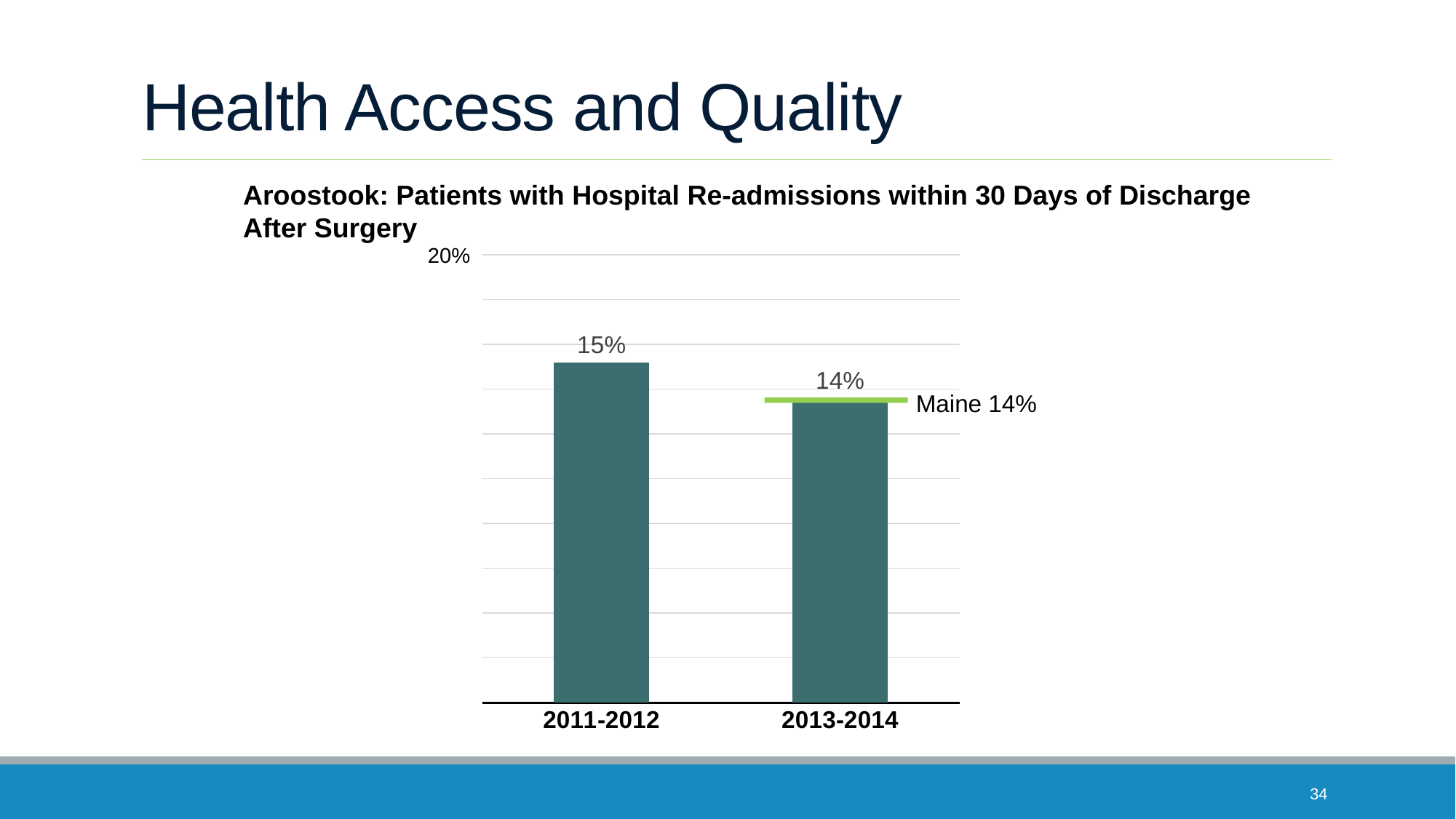
Which period has the highest value? 2011-2012 What is the difference between the 2011-2012 and 2013-2014 values? 1% What is the value for 2013-2014? 14% Which period has the lowest value? 2013-2014 What is the value for 2011-2012? 15% How many periods are shown on the x axis? 2 Is the value for 2011-2012 greater or less than 20%? less What is the title of the chart? Aroostook: Patients with Hospital Re-admissions within 30 Days of Discharge After Surgery What is the Maine reference value marked by the green line? 14% Do the values rise or fall from 2011-2012 to 2013-2014? fall What kind of chart is shown? bar chart Which is larger, the value for 2011-2012 or for 2013-2014? 2011-2012